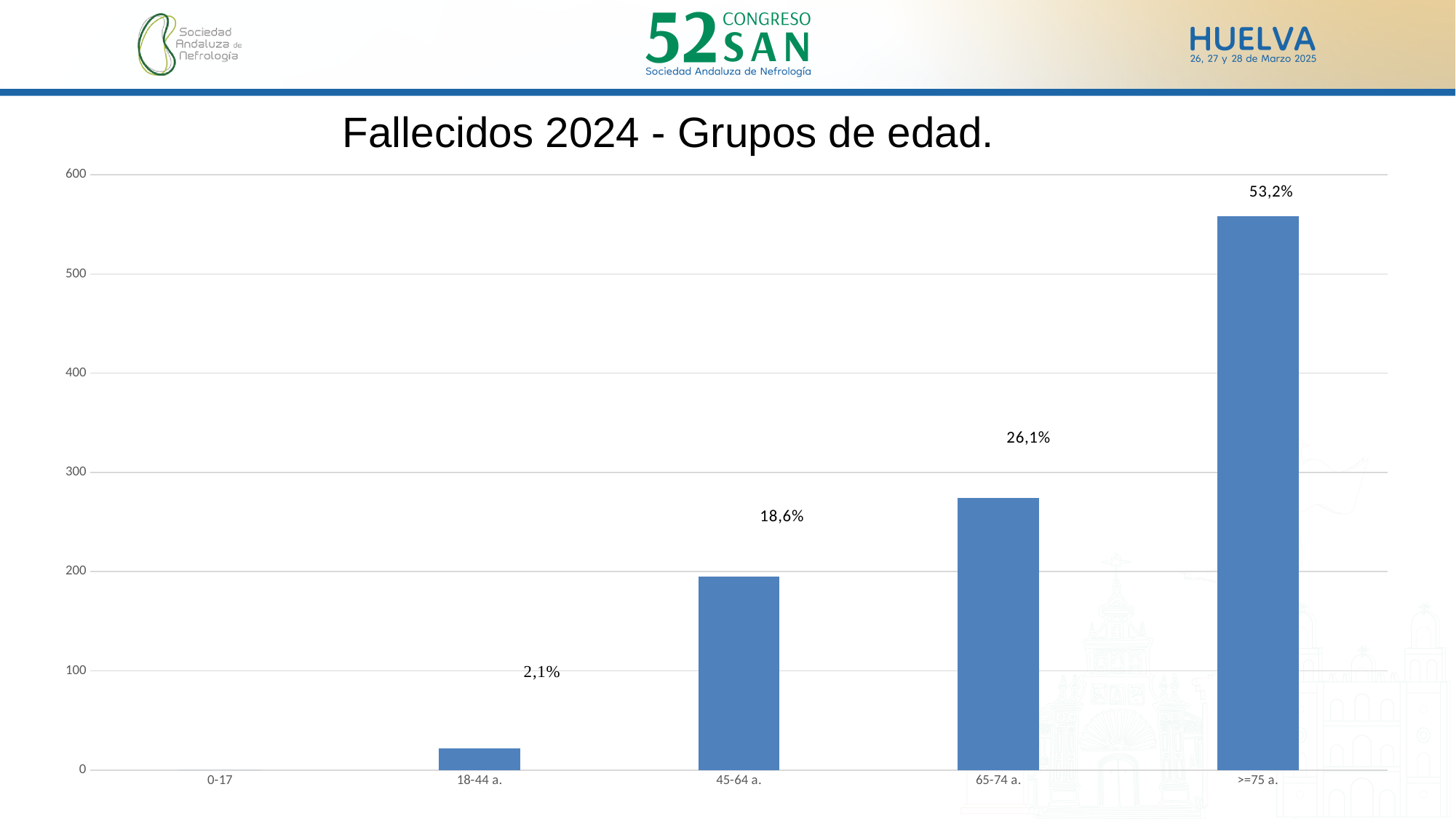
What is the title of the chart? Fallecidos 2024 - Grupos de edad. Is the value for 45-64 a. greater or less than 200? less Do the bar values rise or fall as the age groups move from left to right along the x axis? rise What percentage label is shown for the >=75 a. group? 53,2% Which age group has the highest bar? >=75 a. What kind of chart is shown on the slide? bar chart What is the difference in percentage points between the >=75 a. label and the 65-74 a. label? 27,1 What percentage label is shown for the 18-44 a. group? 2,1% How many age-group categories are shown on the x axis? 5 What percentage label is shown for the 65-74 a. group? 26,1% What percentage label is shown for the 45-64 a. group? 18,6% Which age group has the lowest value among those with a visible bar? 18-44 a.